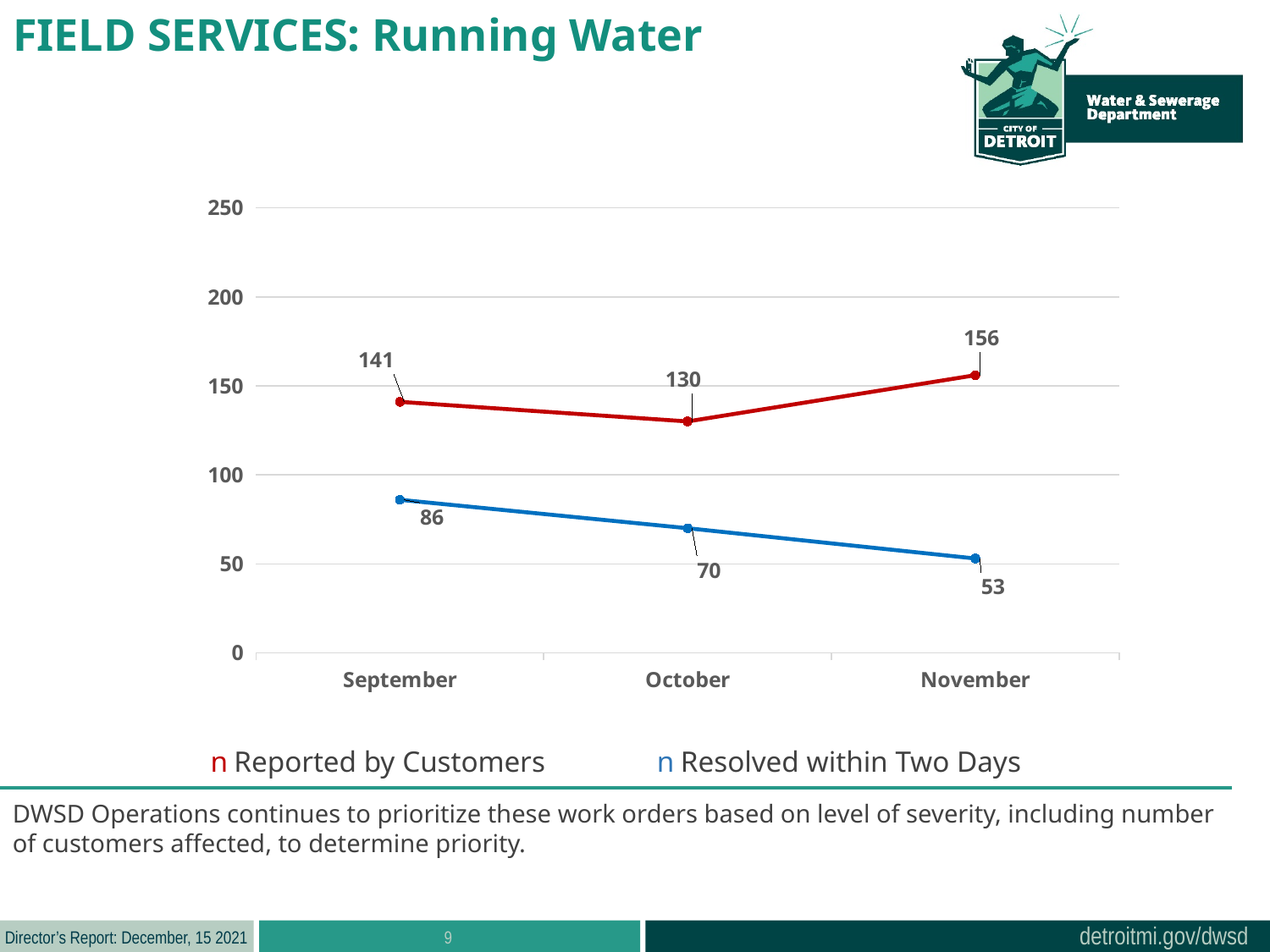
What kind of chart is shown on the slide? line chart In which month is the Resolved within Two Days value lowest? November How many series does the legend list? 2 How many months are shown on the x axis? 3 Is the Reported by Customers value for November greater or less than 150? greater In which month is the Reported by Customers value highest? November What value is shown for Reported by Customers in October? 130 Does the Resolved within Two Days series rise or fall from September to November? fall What value is shown for Resolved within Two Days in November? 53 What is the difference between Reported by Customers and Resolved within Two Days in October? 60 What value is shown for Reported by Customers in September? 141 Which is larger in September: Reported by Customers or Resolved within Two Days? Reported by Customers